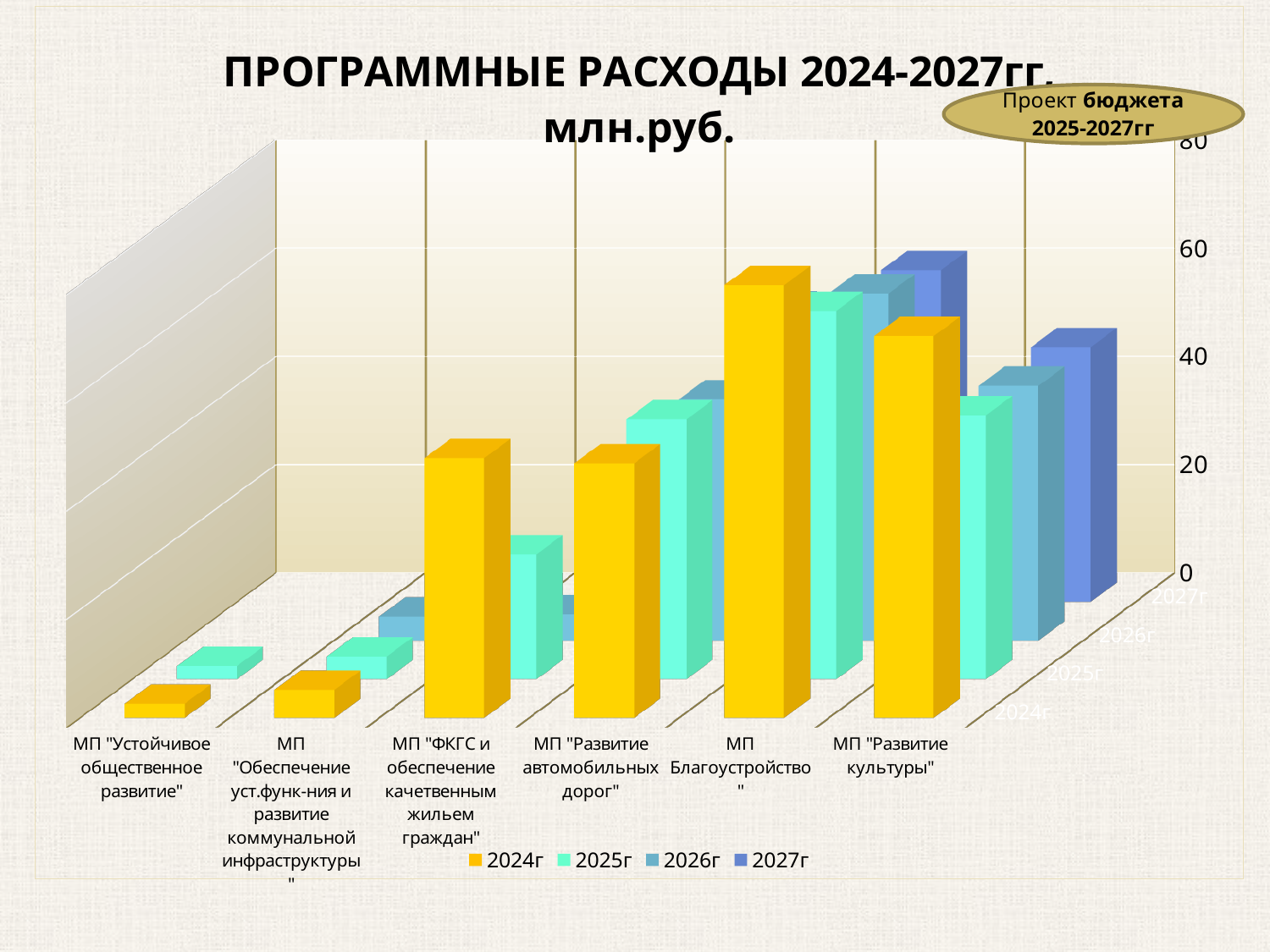
How many series does the legend list? 4 For the 2024г series, which is larger: МП "ФКГС и обеспечение качетвенным жильем граждан" or МП "Устойчивое общественное развитие"? МП "ФКГС и обеспечение качетвенным жильем граждан" Which category has the highest value for the 2024г series? МП "Благоустройство" Is the 2024г value for МП "Благоустройство" greater or less than 40? greater What is the title of the chart? ПРОГРАММНЫЕ РАСХОДЫ 2024-2027гг. млн.руб. Which series is shown in yellow in the legend? 2024г Is the 2024г value for МП "Развитие культуры" greater or less than 20? greater How many categories (programmes) are shown on the x axis? 6 What kind of chart is shown on the slide? bar chart For the 2024г series, which is larger: МП "Благоустройство" or МП "Развитие культуры"? МП "Благоустройство" Is the 2024г value for МП "Устойчивое общественное развитие" greater or less than 20? less